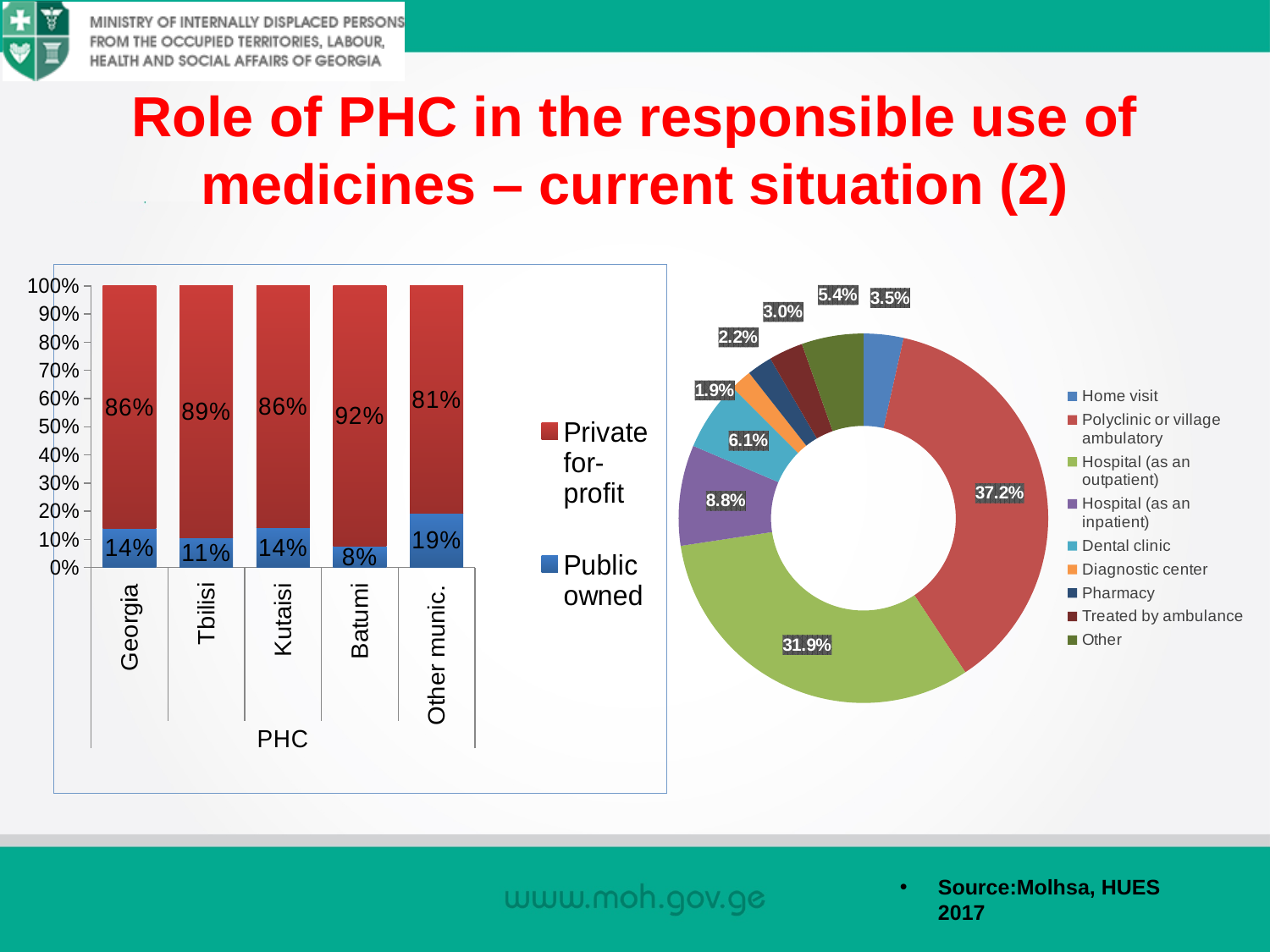
In the doughnut chart on the right, what share is Polyclinic or village ambulatory? 37.2% How many series does the legend of the left bar chart list? 2 How many categories are shown on the x axis of the left bar chart? 5 In the left bar chart, which category has the highest Public owned share? Other munic. In the left bar chart, what is the Public owned share for Batumi? 8% In the doughnut chart on the right, which category has the smallest share? Diagnostic center In the left bar chart, what is the difference between the Private for-profit shares of Batumi and Georgia? 6% In the left bar chart, what is the Private for-profit share for Tbilisi? 89% In the doughnut chart on the right, what is the difference between the Hospital (as an outpatient) and Hospital (as an inpatient) shares? 23.1% In the left bar chart, is the Public owned share larger for Tbilisi or for Kutaisi? Kutaisi What kind of chart is the chart on the left of the slide? Stacked bar chart In the left bar chart, which category has the lowest Private for-profit share? Other munic.